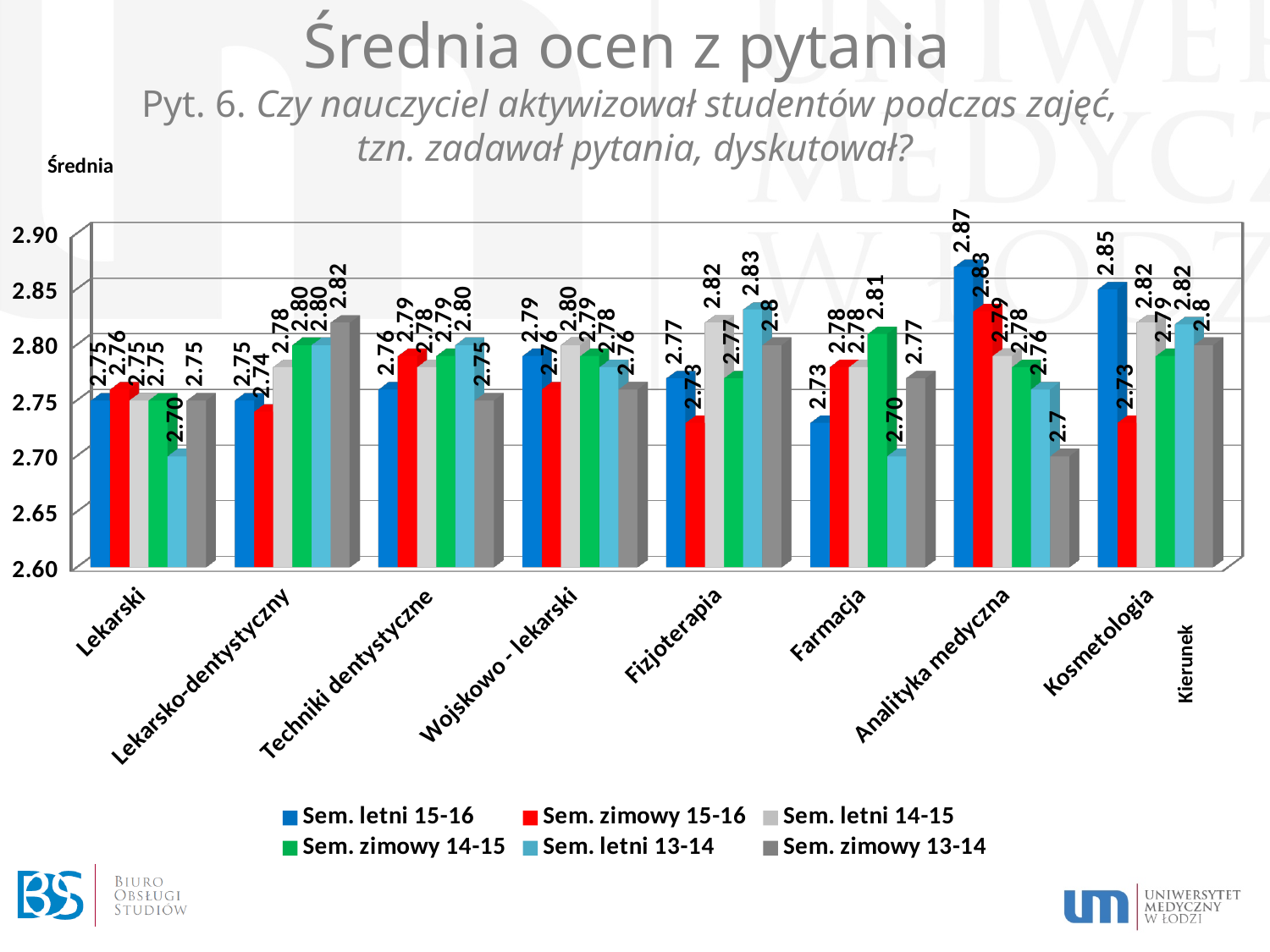
What is the value for Fizjoterapia in Sem. letni 13-14? 2.83 Which field of study has the lowest value in Sem. letni 15-16? Farmacja How many fields of study (kierunek) are shown on the x axis? 8 What is the value for Lekarsko-dentystyczny in Sem. zimowy 13-14? 2.82 What is the label of the vertical axis? Średnia Which field of study has the highest value in Sem. letni 15-16? Analityka medyczna What is the value for Farmacja in Sem. zimowy 14-15? 2.81 For Fizjoterapia, which is larger: the Sem. letni 13-14 value or the Sem. zimowy 15-16 value? Sem. letni 13-14 What type of chart is shown on the slide? bar chart What is the difference between the Sem. letni 15-16 and Sem. zimowy 13-14 values for Analityka medyczna? 0.17 How many series does the legend list? 6 What is the value for Analityka medyczna in Sem. letni 15-16? 2.87